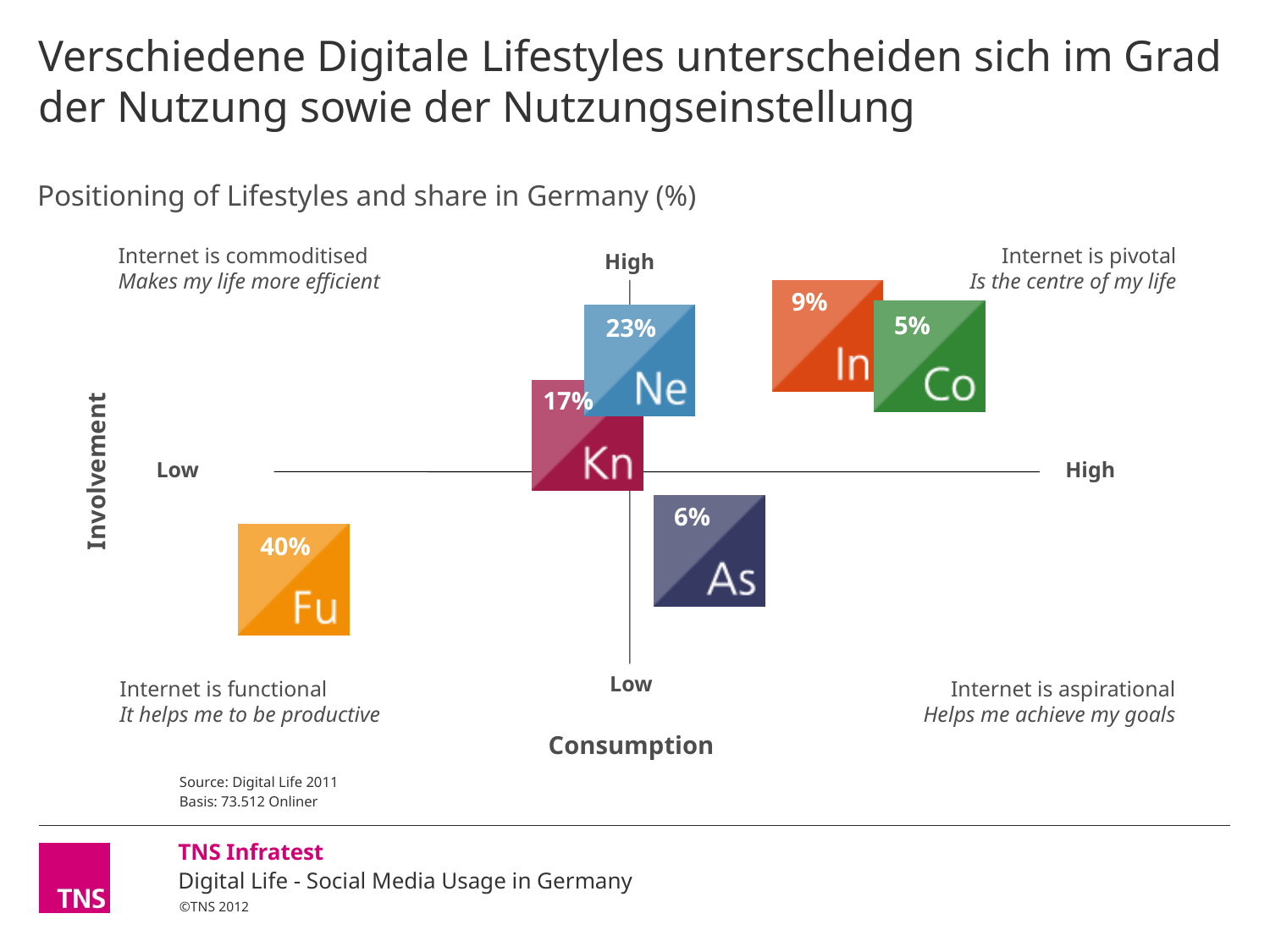
What share is shown for the Kn lifestyle? 17% What is the difference in share between Fu and Ne? 17% What is the label of the horizontal axis? Consumption What is the combined share of As and Co? 11% Which lifestyle has the smallest share? Co What share is shown for the Ne lifestyle? 23% Which has the larger share, Ne or Kn? Ne How many lifestyle tiles are positioned on the chart? 6 What share is shown for the In lifestyle? 9% What is the label of the vertical axis? Involvement What share is shown for the Fu lifestyle? 40% Which lifestyle has the largest share? Fu